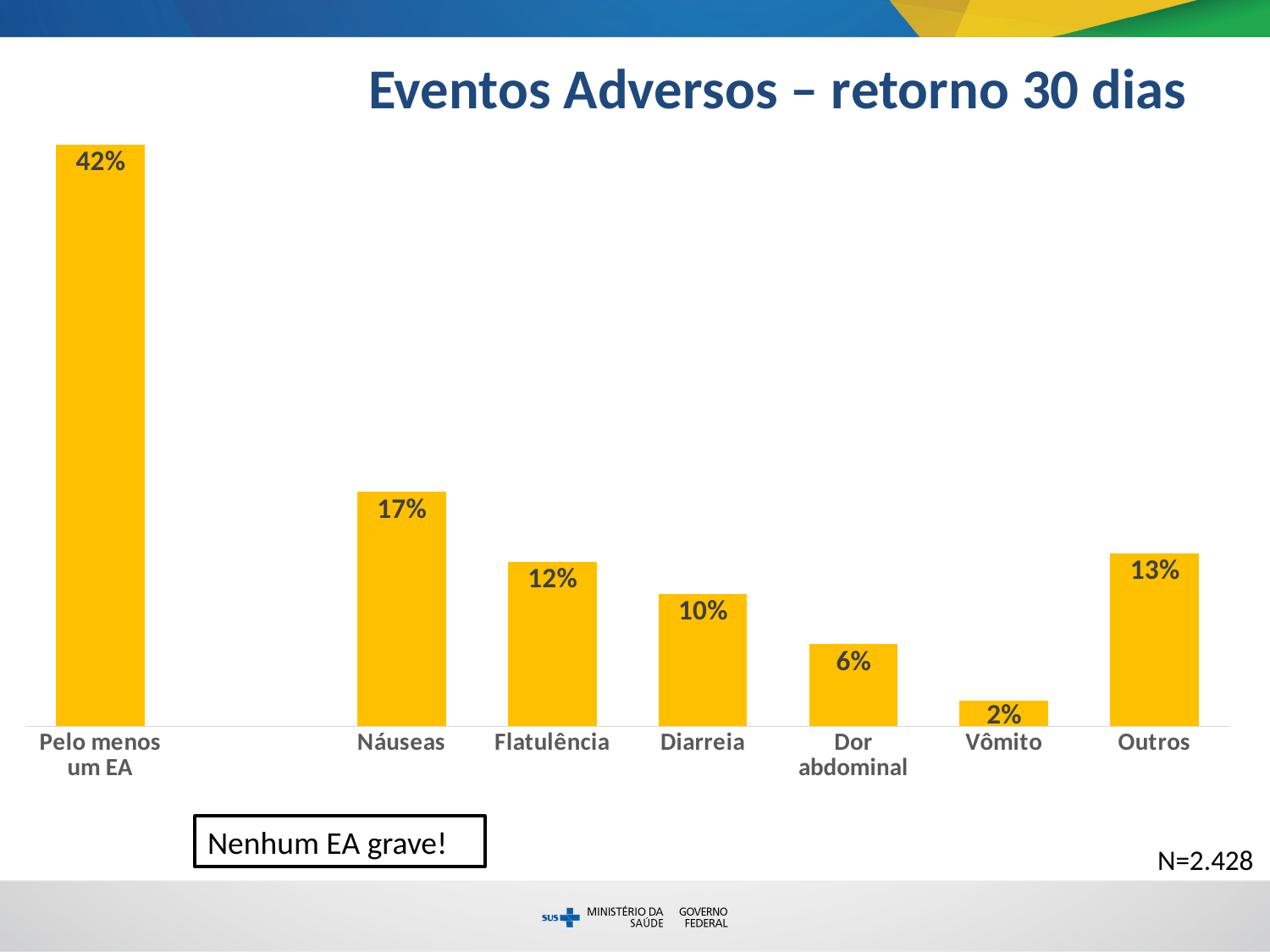
Which is larger, the value for Outros or the value for Flatulência? Outros How many categories are shown on the x axis? 7 What kind of chart is shown on the slide? Bar chart What is the value for Dor abdominal? 6% What is the difference between the values for Pelo menos um EA and Náuseas? 25% Which category has the highest value? Pelo menos um EA What is the value for Flatulência? 12% What is the difference between the values for Diarreia and Vômito? 8% What is the value for Náuseas? 17% What is the title of the chart? Eventos Adversos – retorno 30 dias Which category has the lowest value? Vômito What is the value for Outros? 13%